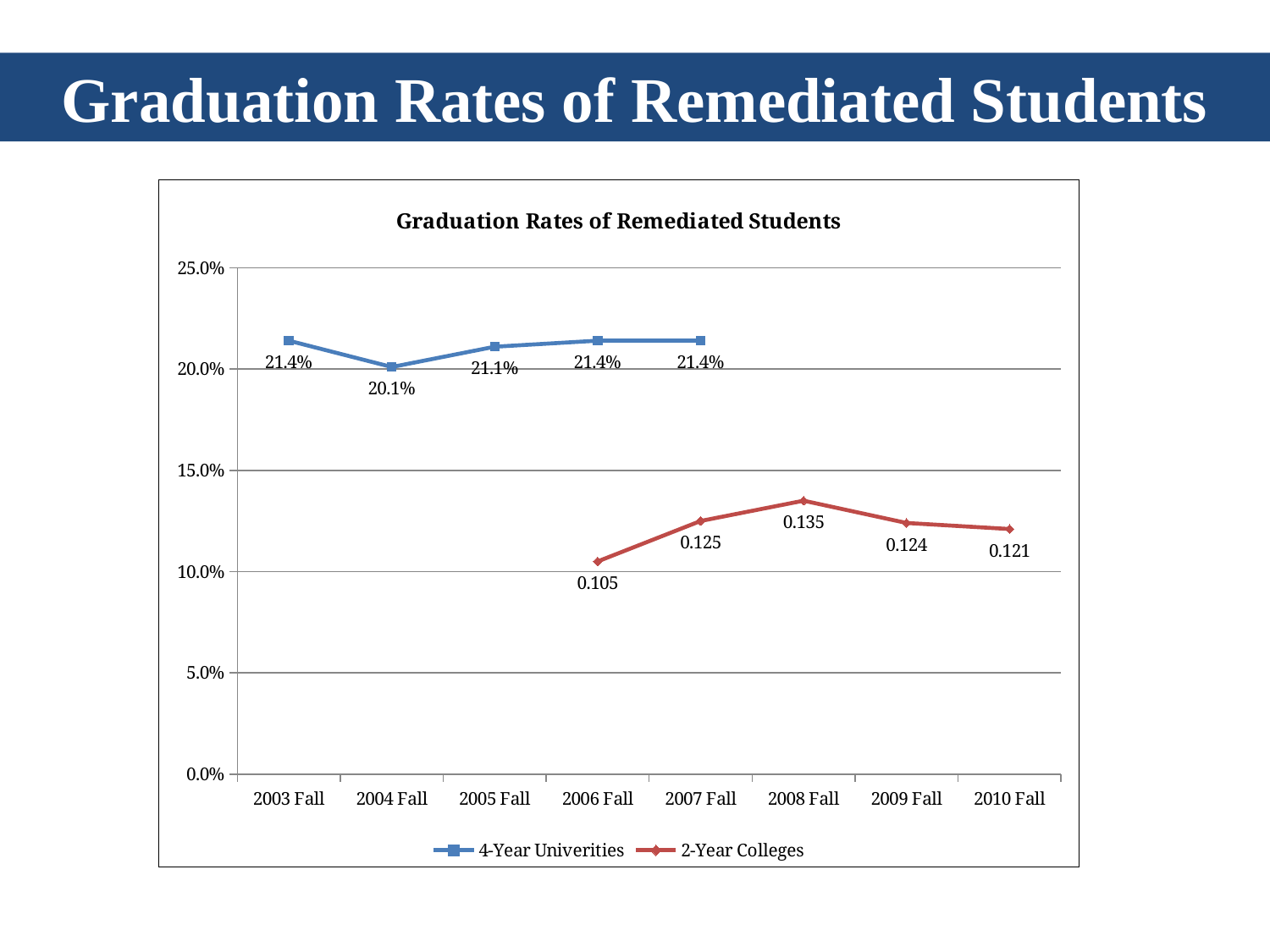
What is the graduation rate for 4-Year Univerities in 2005 Fall? 21.1% What is the graduation rate for 4-Year Univerities in 2004 Fall? 20.1% What is the value for 2-Year Colleges in 2008 Fall? 0.135 What kind of chart is shown? line chart In which year is the 2-Year Colleges value highest? 2008 Fall What is the difference between the 2-Year Colleges values in 2008 Fall and 2006 Fall? 0.03 Which is larger: the 4-Year Univerities rate in 2007 Fall or the 2-Year Colleges value in 2007 Fall? 4-Year Univerities In which year is the 4-Year Univerities graduation rate lowest? 2004 Fall How many categories are shown on the x axis? 8 What is the value for 2-Year Colleges in 2006 Fall? 0.105 How many series does the legend list? 2 Is the 2-Year Colleges value in 2010 Fall greater or less than 15.0%? less